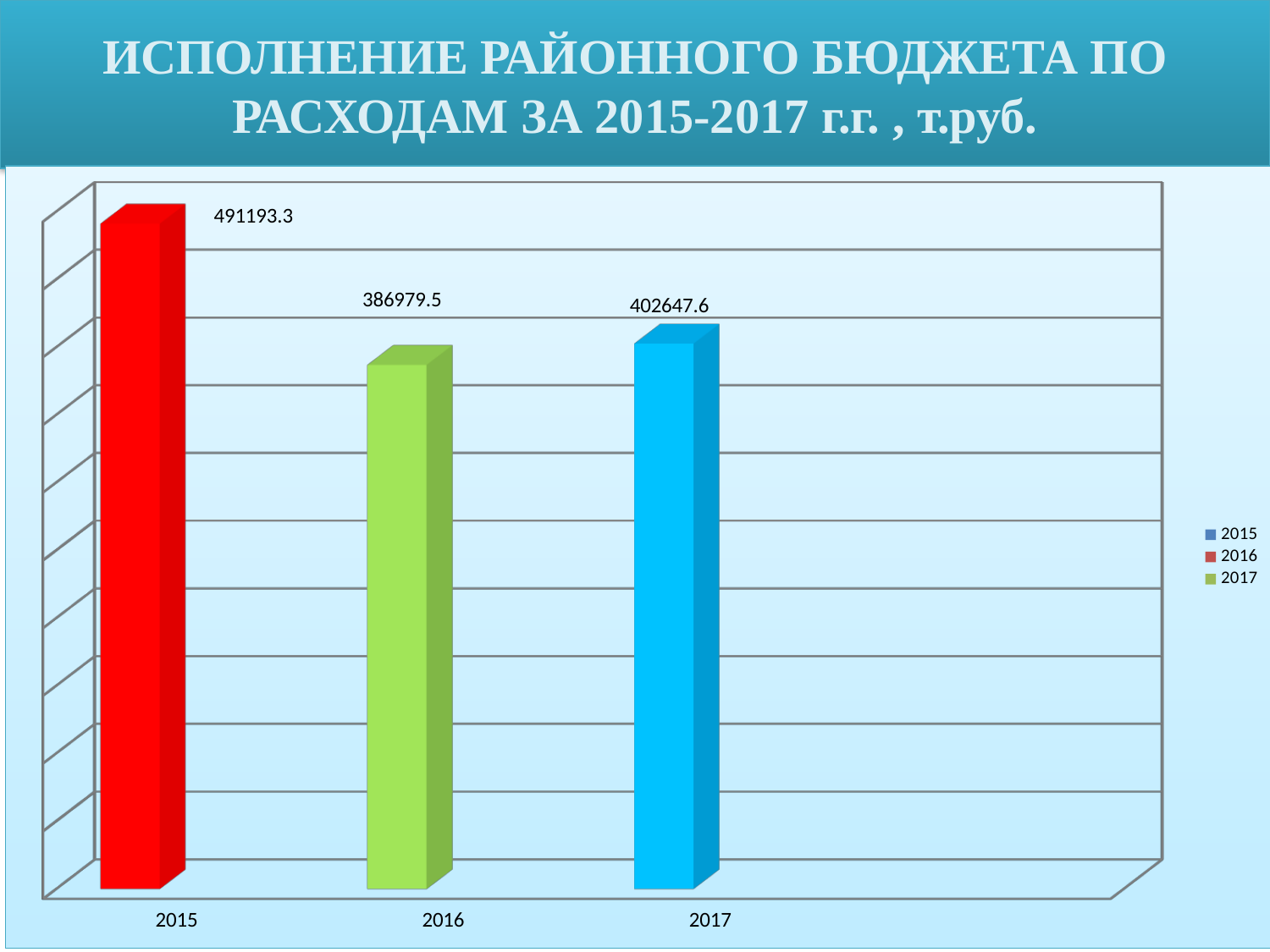
What is the value for 2016? 386979.5 How many bars are plotted on the chart? 3 What is the difference between the values for 2015 and 2016? 104213.8 What is the difference between the values for 2017 and 2016? 15668.1 What is the value for 2015? 491193.3 Which is larger, the value for 2016 or the value for 2017? 2017 How many entries does the legend list? 3 Which year has the highest value? 2015 Does the value rise or fall from 2015 to 2016? fall Which year has the lowest value? 2016 What kind of chart is shown on the slide? bar chart What is the value for 2017? 402647.6